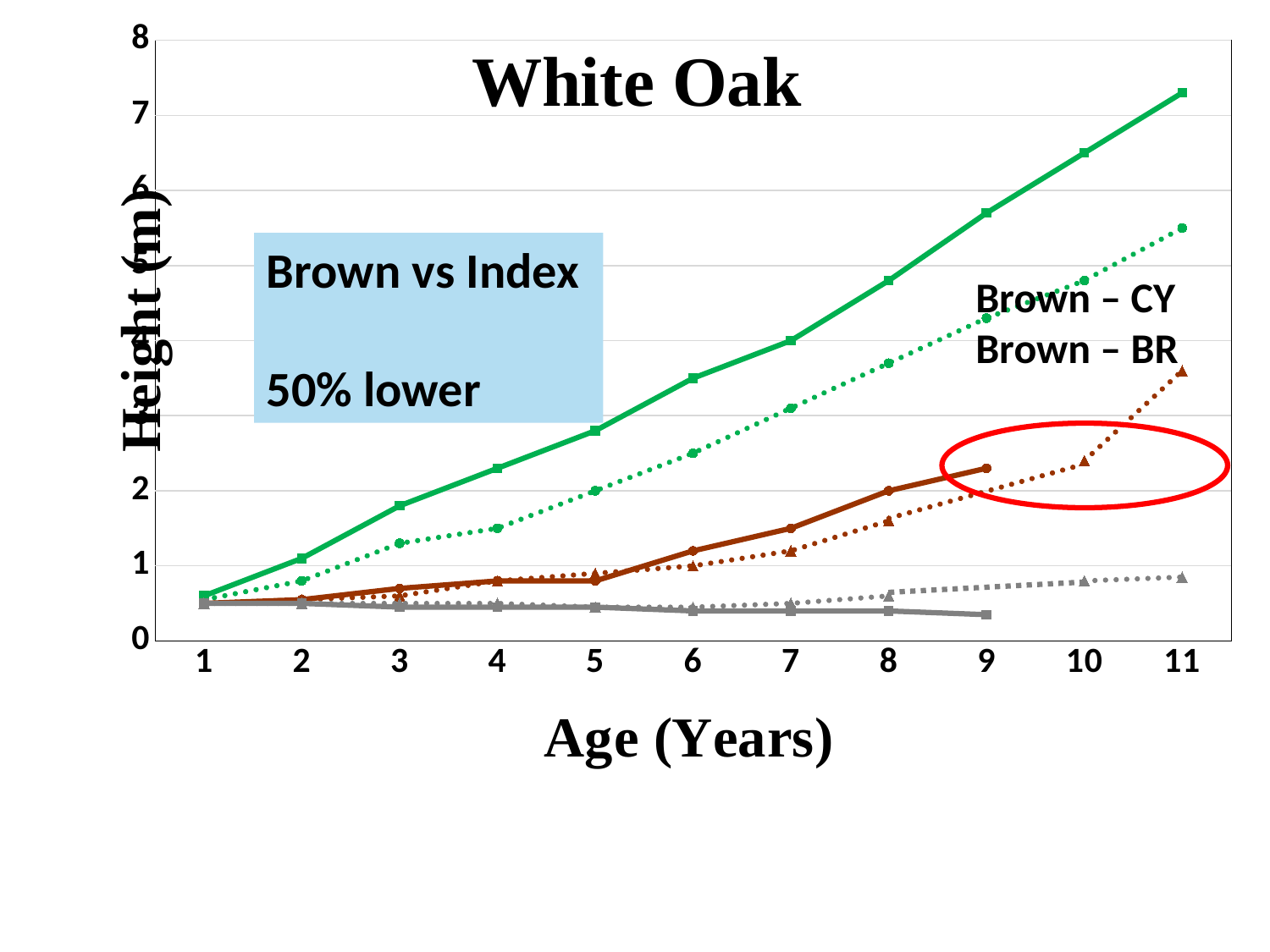
How many age values are shown along the x axis? 11 Is the value of the solid brown line at age 9 greater or less than 2? greater At age 11, which line is higher: the solid green line or the dotted green line? solid green line What is the label of the x axis? Age (Years) Is the value of the dotted green line at age 11 greater or less than 6? less Is the value of the solid gray line at age 9 greater or less than 1? less What is the title of the chart? White Oak At age 8, which line is higher: the solid brown line or the solid gray line? solid brown line Does the solid green line rise or fall as age increases? rise What kind of chart is shown on the slide? line chart